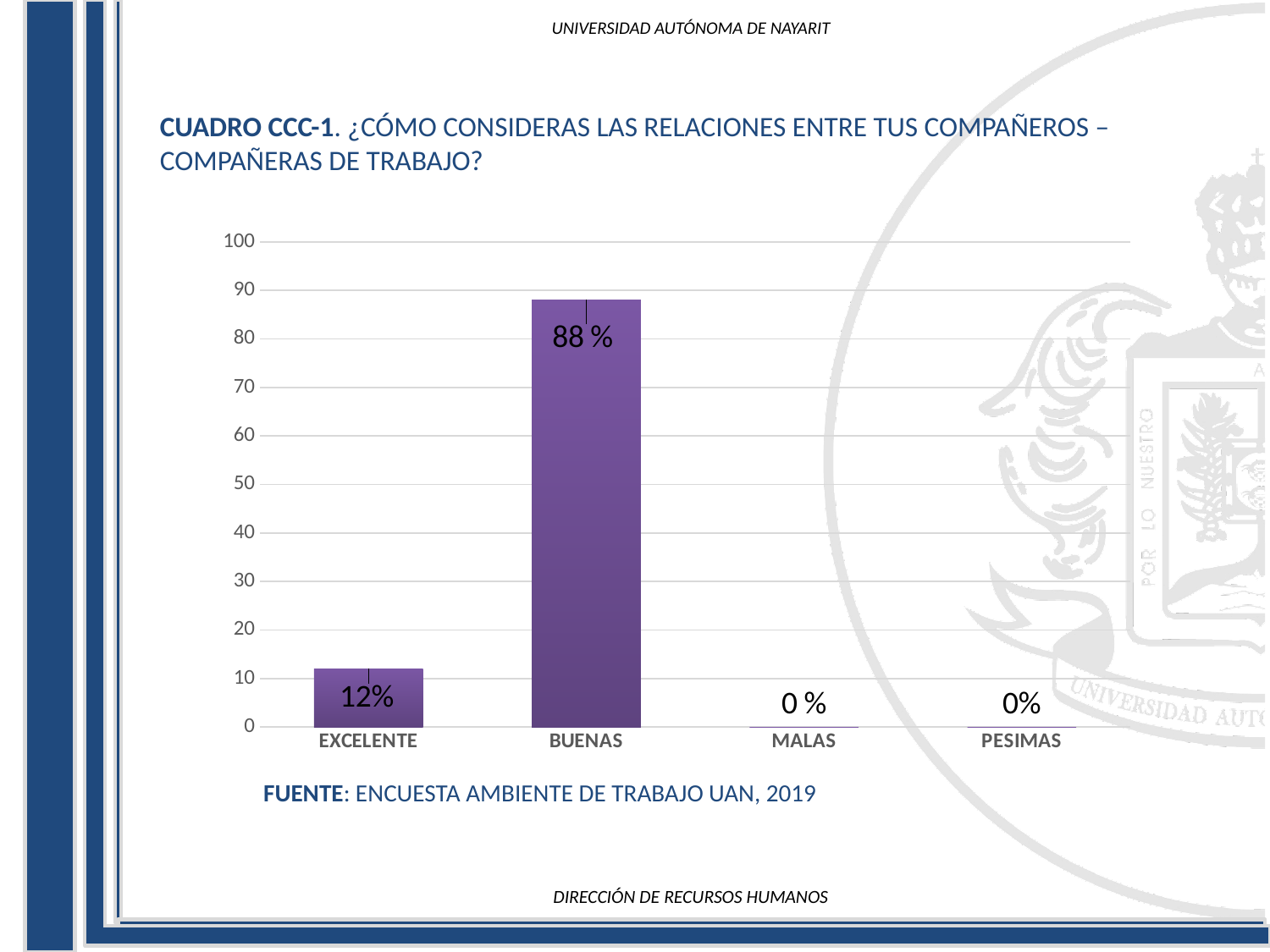
What is the value for PESIMAS? 0% How many categories are shown on the x axis? 4 What is the value for BUENAS? 88 % What is the difference between the values for BUENAS and EXCELENTE? 76% Is the value for EXCELENTE greater or less than 20? less What is the value for MALAS? 0 % Which is larger, the value for EXCELENTE or the value for BUENAS? BUENAS What kind of chart is shown on the slide? bar chart What source is cited below the chart? ENCUESTA AMBIENTE DE TRABAJO UAN, 2019 Is the value for BUENAS greater or less than 80? greater What is the value for EXCELENTE? 12% Which category has the highest value? BUENAS